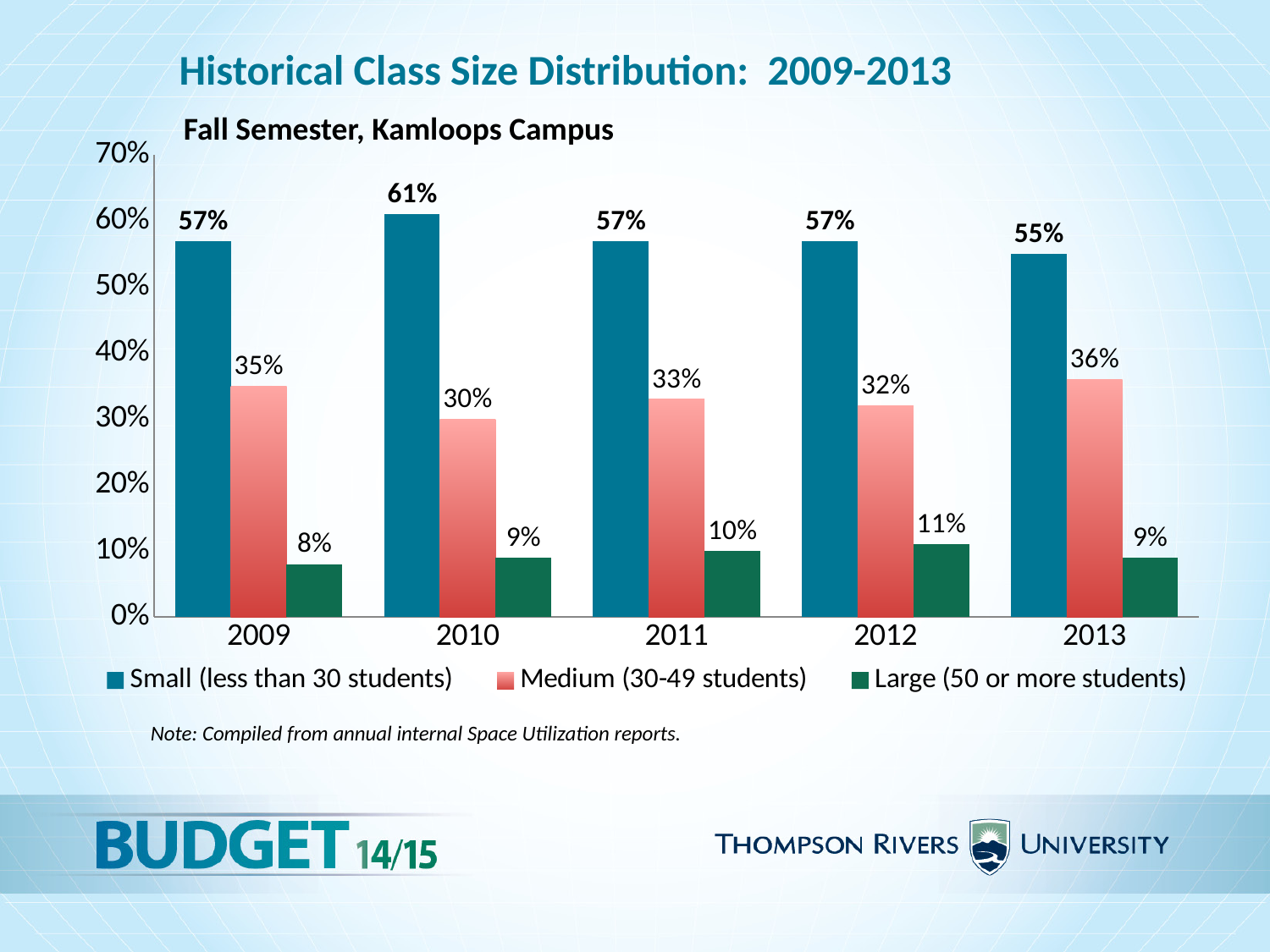
How many years are shown on the x axis? 5 In which year was the share of Large (50 or more students) classes lowest? 2009 What percentage of classes were Medium (30-49 students) in 2013? 36% What percentage of classes were Large (50 or more students) in 2012? 11% How many series does the legend list? 3 What kind of chart is shown on the slide? Bar chart Which was larger in 2011: the Medium (30-49 students) share or the Large (50 or more students) share? Medium (30-49 students) What is the difference between the Medium (30-49 students) share in 2009 and in 2010? 5% What percentage of classes were Small (less than 30 students) in 2010? 61% In which year was the share of Small (less than 30 students) classes highest? 2010 Is the Small (less than 30 students) value for 2013 greater or less than 50%? greater What is the subtitle shown above the chart? Fall Semester, Kamloops Campus